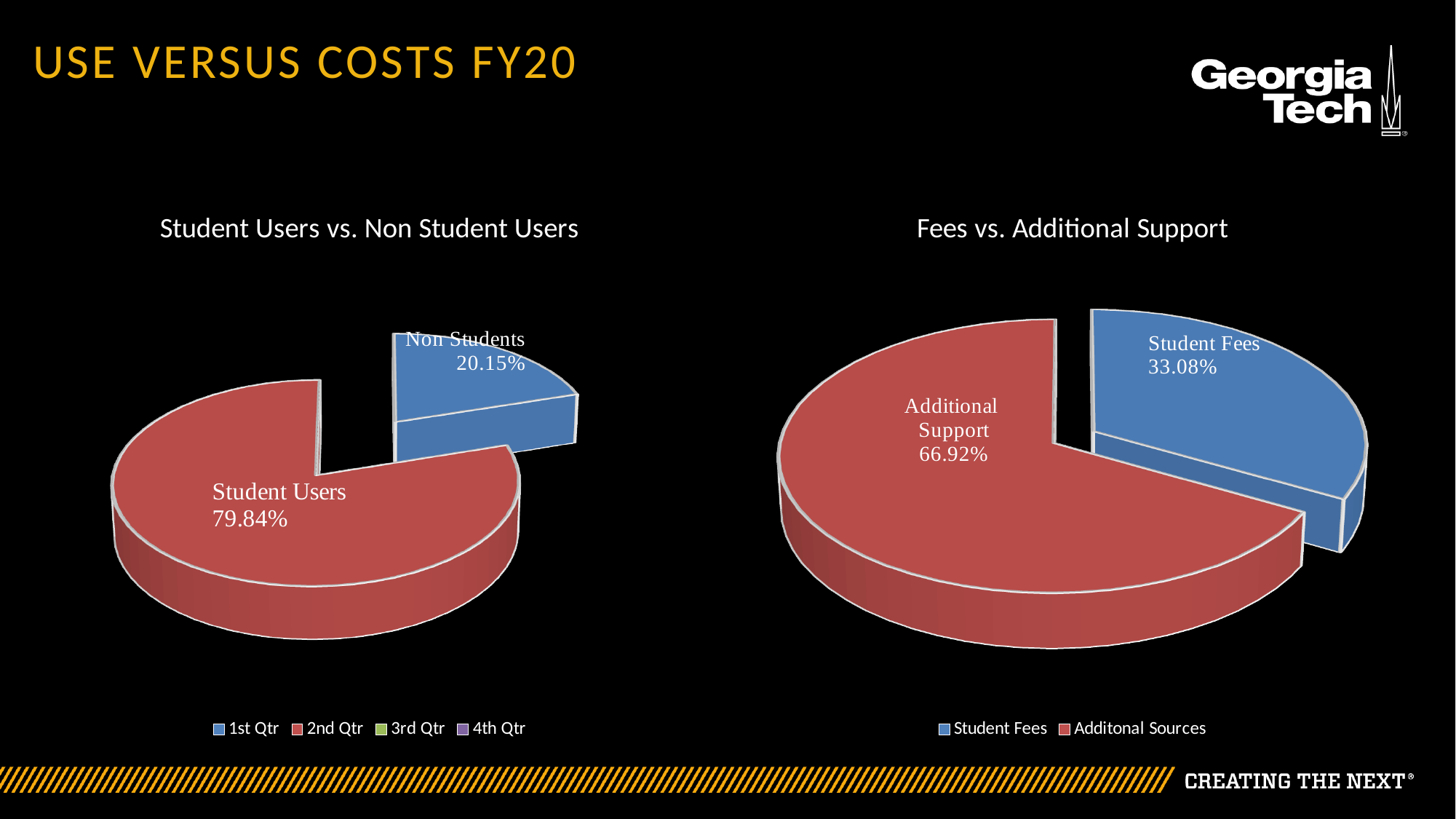
In the 'Fees vs. Additional Support' chart, what is the difference in percentage points between Additional Support and Student Fees? 33.84 In the 'Fees vs. Additional Support' chart, which is larger: Student Fees or Additional Support? Additional Support In the 'Fees vs. Additional Support' chart, what share of the pie is Student Fees? 33.08% In the 'Student Users vs. Non Student Users' chart, which slice is the largest? Student Users How many slices does the 'Student Users vs. Non Student Users' chart have? 2 In the 'Fees vs. Additional Support' chart, which slice is the smallest? Student Fees In the 'Student Users vs. Non Student Users' chart, what share of the pie is Student Users? 79.84% What kind of chart is the 'Fees vs. Additional Support' chart? Pie chart In the 'Fees vs. Additional Support' chart, what share of the pie is Additional Support? 66.92% In the 'Student Users vs. Non Student Users' chart, what is the difference in percentage points between Student Users and Non Students? 59.69 How many entries does the legend of the 'Student Users vs. Non Student Users' chart list? 4